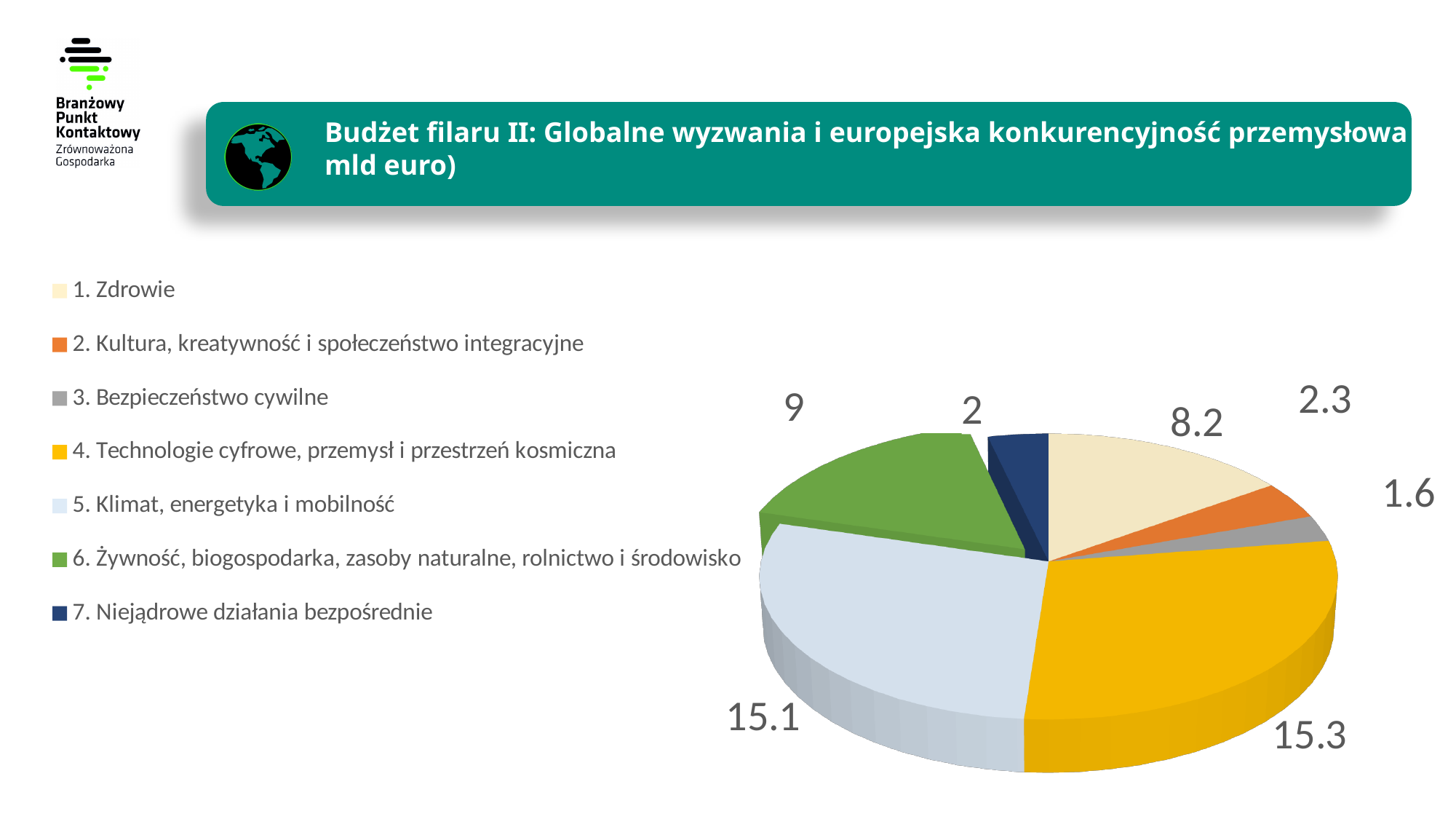
Which category has the smallest slice of the pie? 3. Bezpieczeństwo cywilne What colour is the slice for '6. Żywność, biogospodarka, zasoby naturalne, rolnictwo i środowisko'? Green What value is shown for the slice '4. Technologie cyfrowe, przemysł i przestrzeń kosmiczna'? 15.3 What is the difference between the values for '6. Żywność, biogospodarka, zasoby naturalne, rolnictwo i środowisko' and '7. Niejądrowe działania bezpośrednie'? 7 What value is shown for the slice '1. Zdrowie'? 8.2 What type of chart is shown on the slide? Pie chart Which category has the largest slice of the pie? 4. Technologie cyfrowe, przemysł i przestrzeń kosmiczna What is the difference between the values for '1. Zdrowie' and '2. Kultura, kreatywność i społeczeństwo integracyjne'? 5.9 How many categories does the pie chart have? 7 What value is shown for the slice '7. Niejądrowe działania bezpośrednie'? 2 Which is larger: the value for '5. Klimat, energetyka i mobilność' or the value for '6. Żywność, biogospodarka, zasoby naturalne, rolnictwo i środowisko'? 5. Klimat, energetyka i mobilność What value is shown for the slice '3. Bezpieczeństwo cywilne'? 1.6